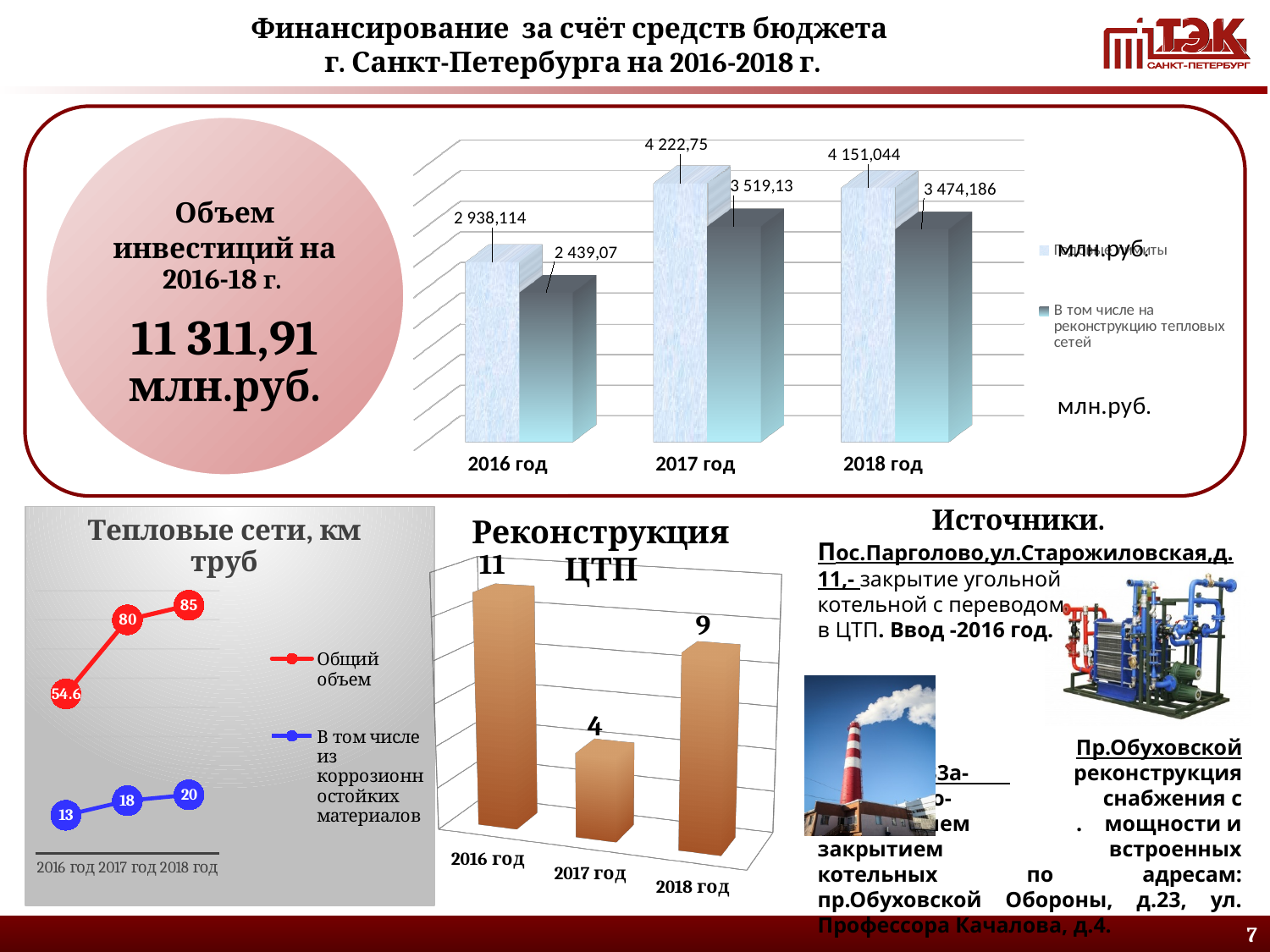
In the top bar chart on budget financing, which year has the highest value for 'В том числе на реконструкцию тепловых сетей'? 2017 год In the top bar chart on budget financing, what is the value of the taller (light blue) bar for 2016 год? 2 938,114 In the 'Тепловые сети, км труб' chart, what is the value of 'В том числе из коррозионностойких материалов' for 2018 год? 20 In the 'Тепловые сети, км труб' chart, what is the value of 'Общий объем' for 2016 год? 54.6 In the 'Тепловые сети, км труб' chart, does 'Общий объем' rise or fall from 2016 год to 2018 год? rise In the 'Тепловые сети, км труб' chart, what is the difference between 'Общий объем' in 2018 год and 2017 год? 5 What kind of chart is 'Тепловые сети, км труб'? line chart In the top bar chart on budget financing, what is the value for 'В том числе на реконструкцию тепловых сетей' in 2017 год? 3 519,13 In the 'Реконструкция ЦТП' chart, which year has the lowest value? 2017 год In the top bar chart on budget financing, how many series does the legend list? 2 In the top bar chart on budget financing, is the value for 'В том числе на реконструкцию тепловых сетей' in 2016 год larger or smaller than in 2018 год? smaller In the 'Реконструкция ЦТП' chart, what is the difference between the values for 2016 год and 2018 год? 2